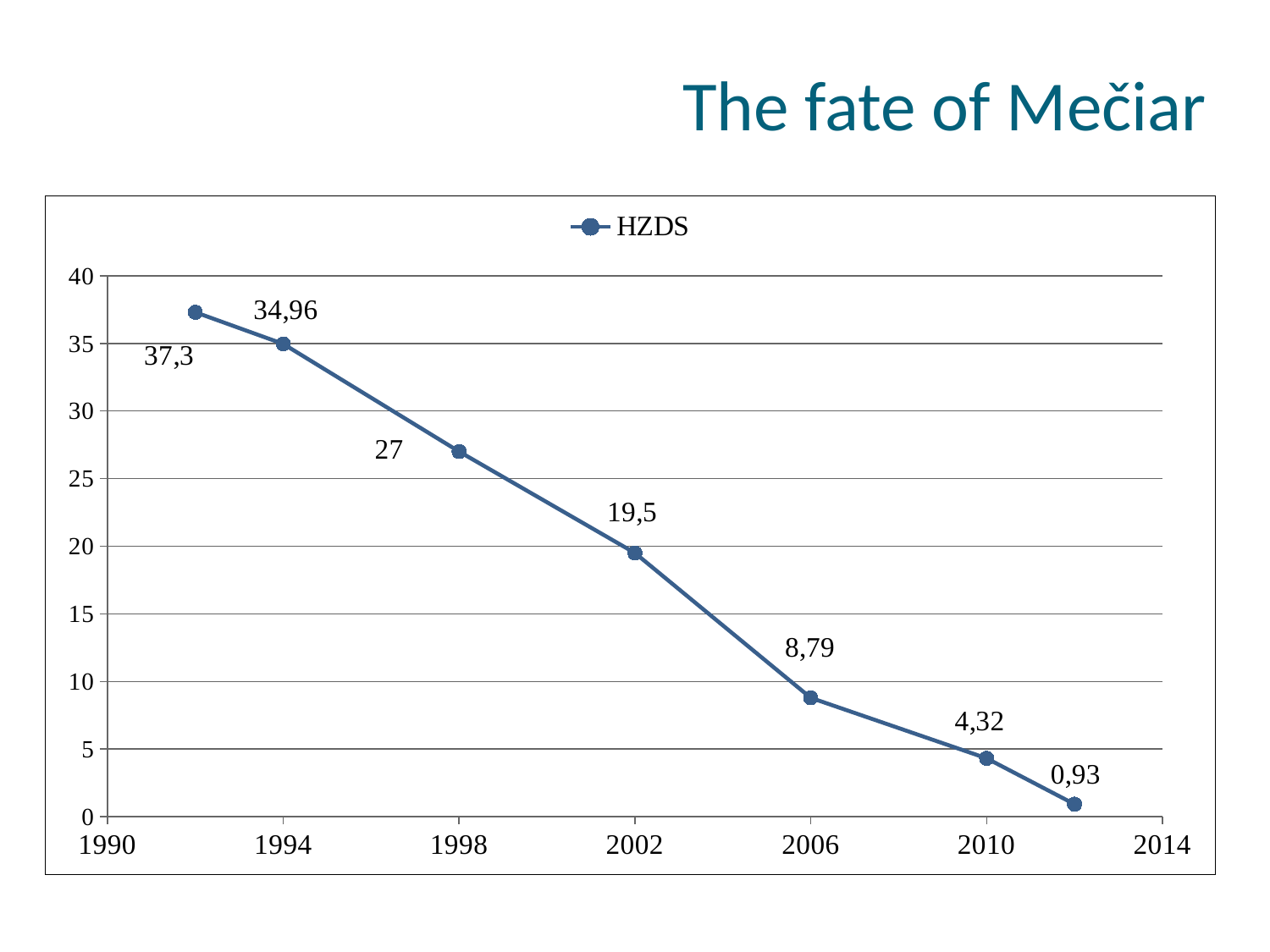
What is the difference between the HZDS values in 1998 and 2002? 7,5 Do the HZDS values rise or fall over time along the x axis? fall What is the HZDS value in 2010? 4,32 What is the highest value plotted on the HZDS line? 37,3 What is the HZDS value in 1998? 27 What is the HZDS value in 2006? 8,79 Which is larger, the HZDS value in 2006 or in 2010? 2006 What is the value of the last (rightmost) data point on the line? 0,93 What is the lowest value plotted on the HZDS line? 0,93 What is the HZDS value in 2002? 19,5 How many data points are plotted on the line? 7 What type of chart is shown on the slide? line chart